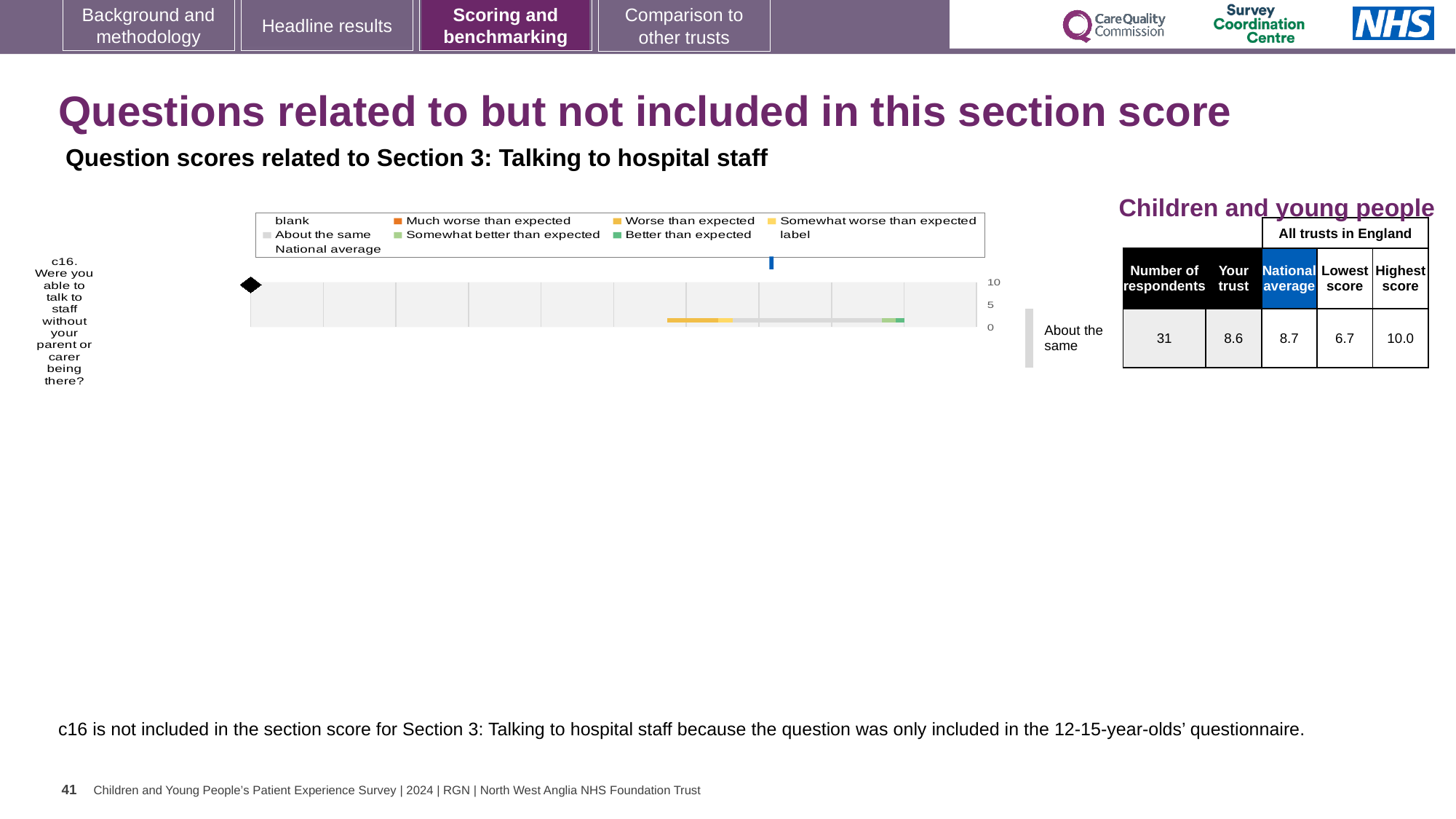
How many respondents answered c16 for this trust? 31 Which question number is plotted in the chart? c16 How many survey questions are plotted in the chart? 1 What is the highest value shown on the chart's score axis? 10 What is the difference between the highest score and the lowest score for c16? 3.3 In the table beside the chart, what is the highest score among all trusts in England for c16? 10.0 What kind of chart is shown on the slide? bar chart Is the national average marker for c16 greater or less than 5? greater In the table beside the chart, what is the 'Your trust' score for c16? 8.6 Which is larger for c16: the 'Your trust' score or the national average? National average In the table beside the chart, what is the national average score for c16? 8.7 In the table beside the chart, what is the lowest score among all trusts in England for c16? 6.7